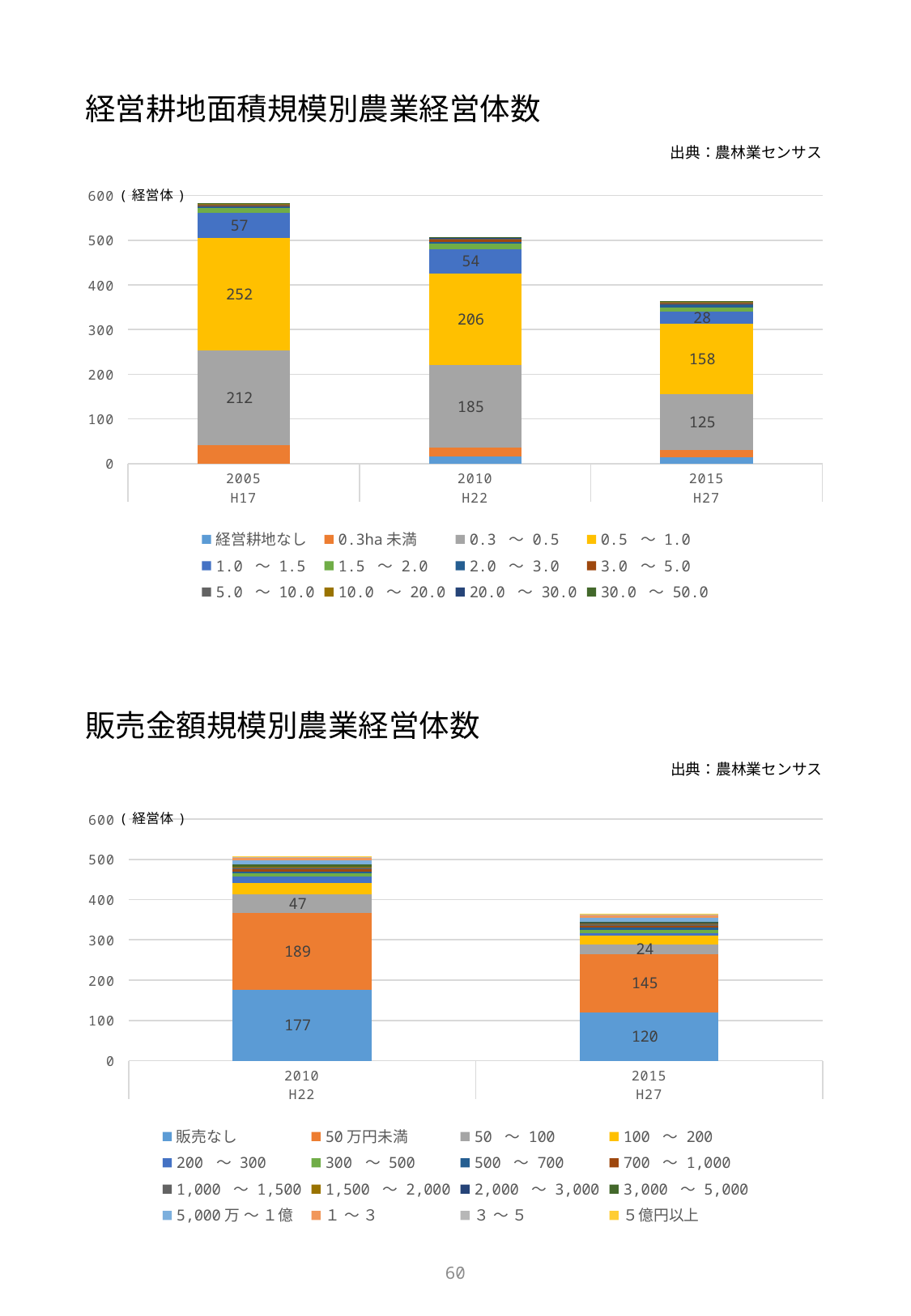
In the top chart (経営耕地面積規模別農業経営体数), by how much did the 0.3 ～ 0.5 segment decrease from 2005 to 2015? 87 In the top chart (経営耕地面積規模別農業経営体数), does the 1.0 ～ 1.5 segment rise or fall from 2005 to 2015? fall In the top chart (経営耕地面積規模別農業経営体数), which year has the highest value for the 0.5 ～ 1.0 segment? 2005 (H17) What type of chart is the bottom chart (販売金額規模別農業経営体数)? stacked bar chart In the top chart (経営耕地面積規模別農業経営体数), what is the value of the 0.5 ～ 1.0 segment for 2005 (H17)? 252 In the bottom chart (販売金額規模別農業経営体数), what is the value of the 50万円未満 segment for 2015 (H27)? 145 In the top chart (経営耕地面積規模別農業経営体数), how many years are shown on the x axis? 3 In the bottom chart (販売金額規模別農業経営体数), is the total height of the 2015 (H27) bar greater or less than 400? less In the top chart (経営耕地面積規模別農業経営体数), what is the value of the 1.0 ～ 1.5 segment for 2010 (H22)? 54 In the bottom chart (販売金額規模別農業経営体数), what is the difference between the 50 ～ 100 segment in 2010 and in 2015? 23 In the top chart (経営耕地面積規模別農業経営体数), what is the value of the 0.3 ～ 0.5 segment for 2015 (H27)? 125 In the bottom chart (販売金額規模別農業経営体数), what is the value of the 販売なし segment for 2010 (H22)? 177